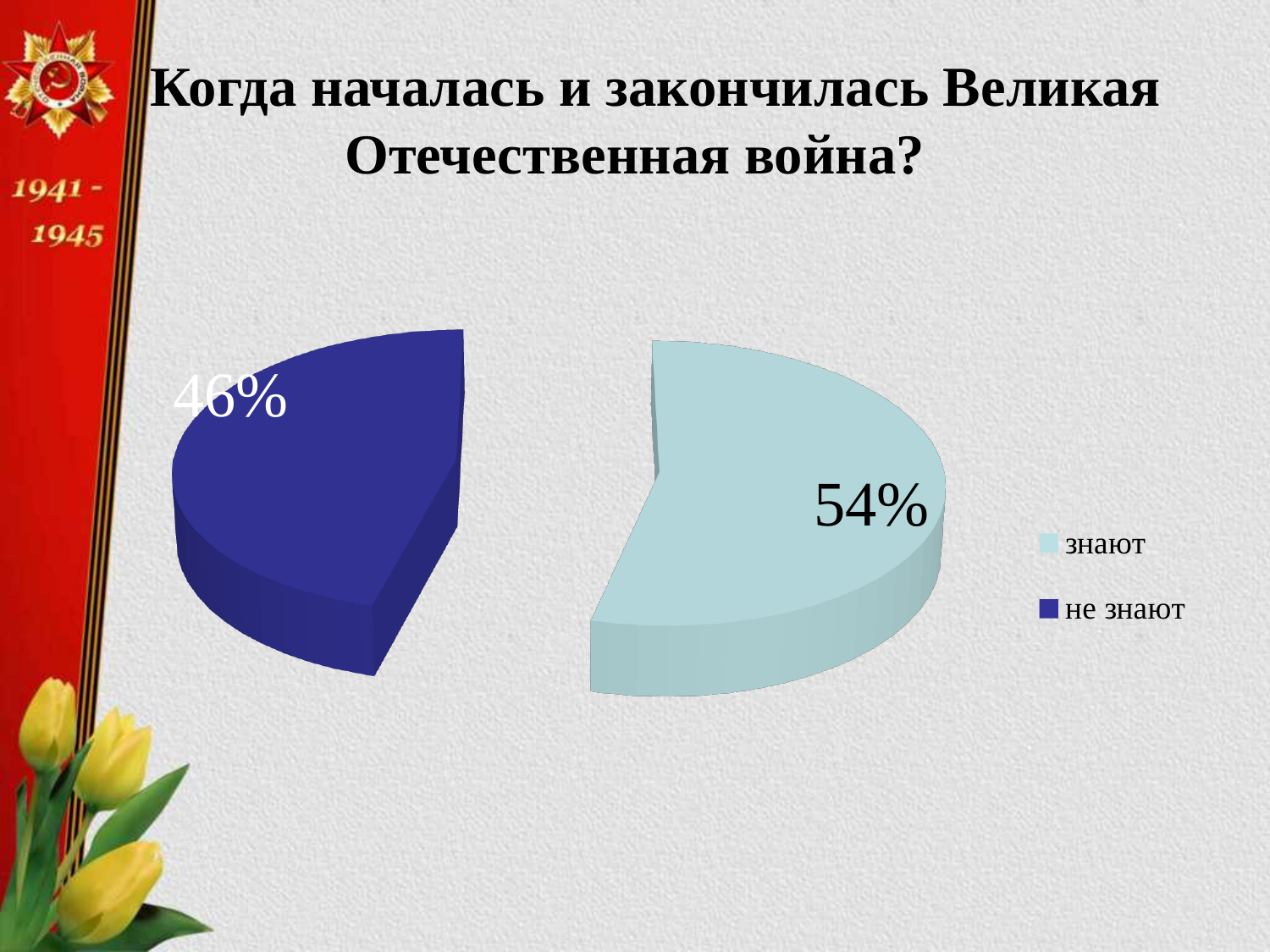
Which slice is the largest? знают How many entries does the legend list? 2 Which is larger, the "знают" slice or the "не знают" slice? знают What share of the pie is labelled "не знают"? 46% What share of the pie is labelled "знают"? 54% Is the share for "знают" greater or less than 50%? greater Which slice is the smallest? не знают What is the title of the slide above the chart? Когда началась и закончилась Великая Отечественная война? How many slices does the pie chart have? 2 What colour is the "не знают" slice? dark blue What kind of chart is shown on the slide? pie chart What is the difference between the "знают" and "не знают" shares? 8%